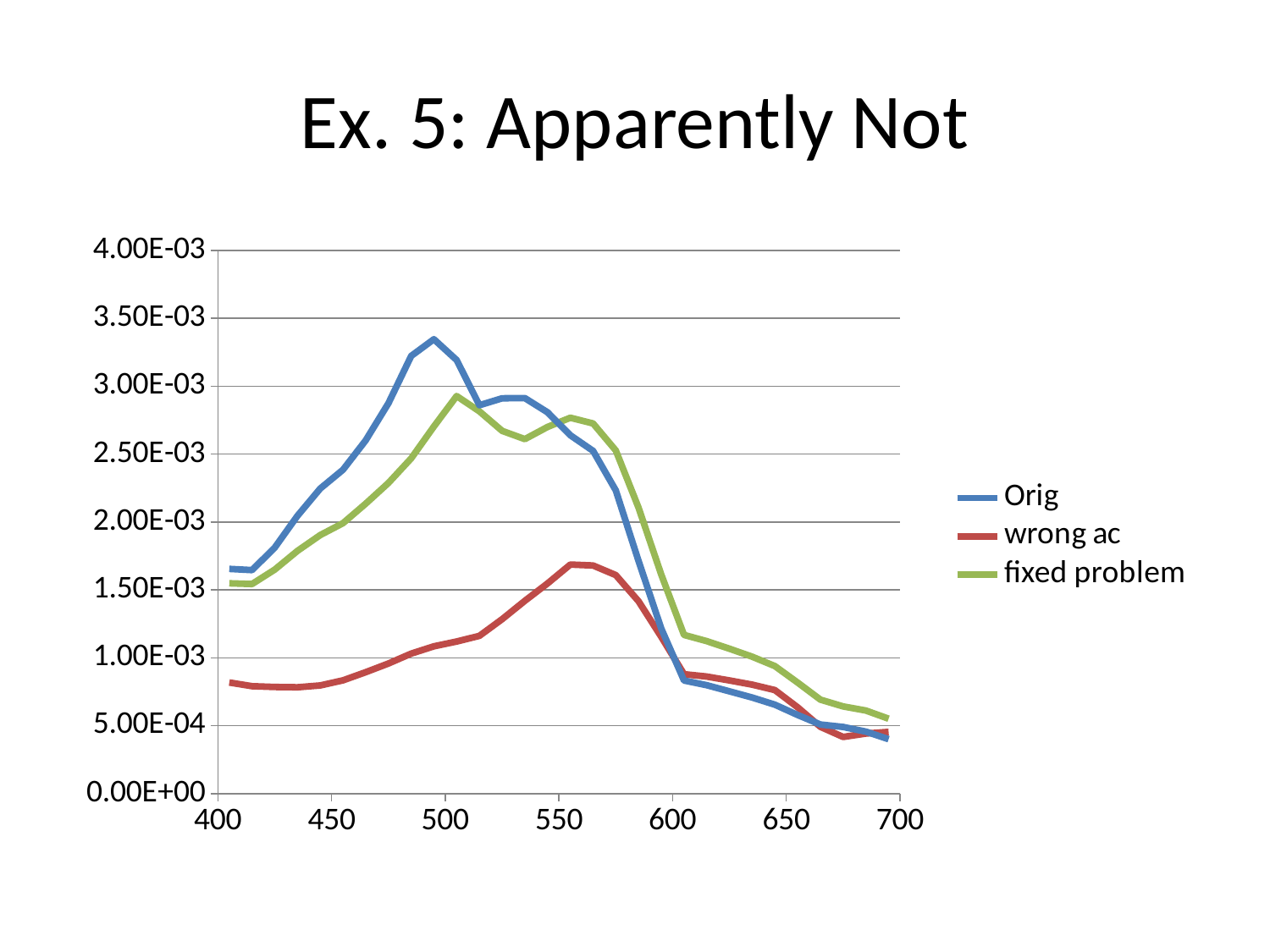
Is the value of the 'Orig' series at x = 650 greater or less than 1.00E-03? less What is the title of the slide containing the chart? Ex. 5: Apparently Not What colour is the line for the 'Orig' series? blue At x = 500, which series has the larger value, 'Orig' or 'fixed problem'? Orig Does the 'Orig' series rise or fall between x = 600 and x = 700? fall Which series has the lowest value at x = 500? wrong ac What kind of chart is shown on the slide? line chart Is the value of the 'wrong ac' series at x = 450 greater or less than 1.00E-03? less Which series reaches the highest value anywhere on the chart? Orig At x = 650, which series has the larger value, 'wrong ac' or 'fixed problem'? fixed problem How many series does the legend list? 3 Is the value of the 'Orig' series at x = 500 greater or less than 3.00E-03? greater